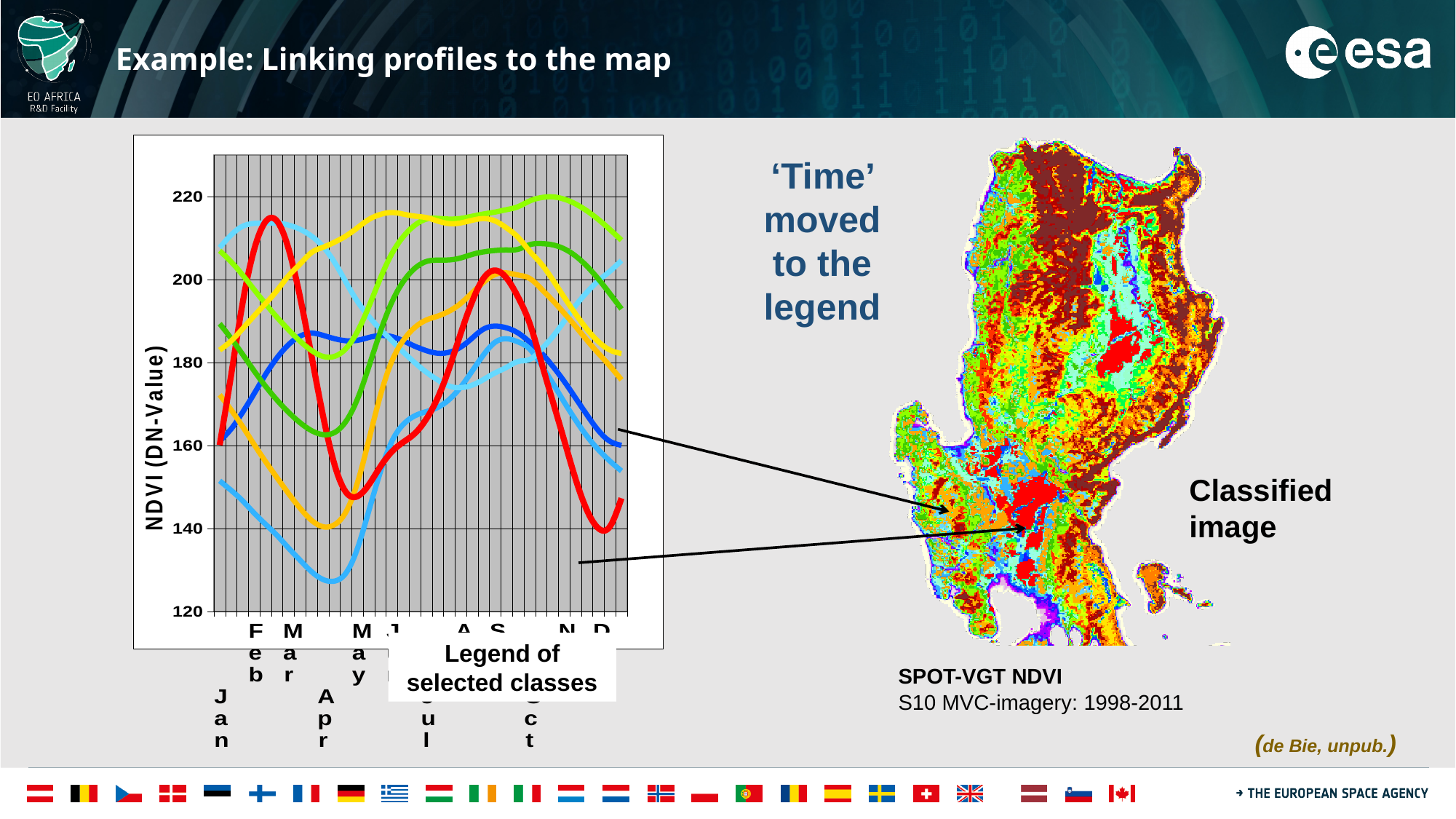
What is the highest value shown on the vertical axis of the chart? 220 Is the value of the dark blue line in Jan greater or less than 180? less What kind of chart is shown on the left of the slide? line chart Is the value of the light blue line in Apr greater or less than 140? less Does the red line rise or fall from Sep to Dec? fall How many months are plotted along the x axis of the chart? 12 Is the value of the red line in Feb greater or less than 200? greater Does the light blue line rise or fall from Jan to Apr? fall What is the label of the vertical axis of the chart? NDVI (DN-Value) Which line reaches the lowest NDVI value anywhere on the chart? the light blue line